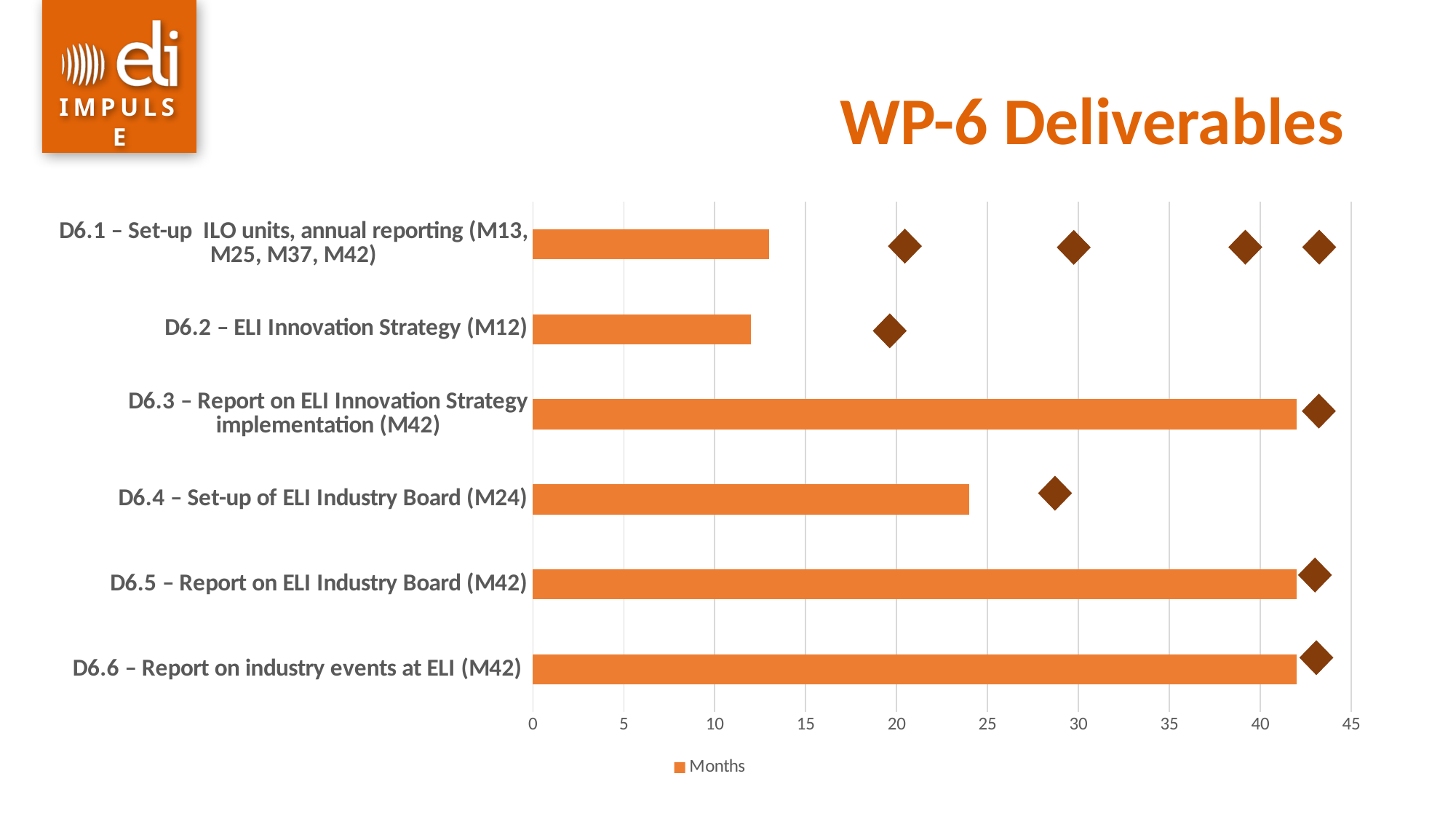
Is the bar for D6.2 – ELI Innovation Strategy (M12) greater or less than 15? less How many series does the legend list? 1 Which bar is longer: D6.5 – Report on ELI Industry Board (M42) or D6.1 – Set-up ILO units, annual reporting? D6.5 – Report on ELI Industry Board (M42) What is the title of the slide containing the chart? WP-6 Deliverables Is the bar for D6.4 – Set-up of ELI Industry Board (M24) greater or less than 25? less What kind of chart is shown on the slide? bar chart What is the legend entry shown below the chart? Months Which bar is longer: D6.4 – Set-up of ELI Industry Board (M24) or D6.2 – ELI Innovation Strategy (M12)? D6.4 – Set-up of ELI Industry Board (M24) Is the bar for D6.4 – Set-up of ELI Industry Board (M24) greater or less than 20? greater How many deliverables (categories) are plotted on the chart? 6